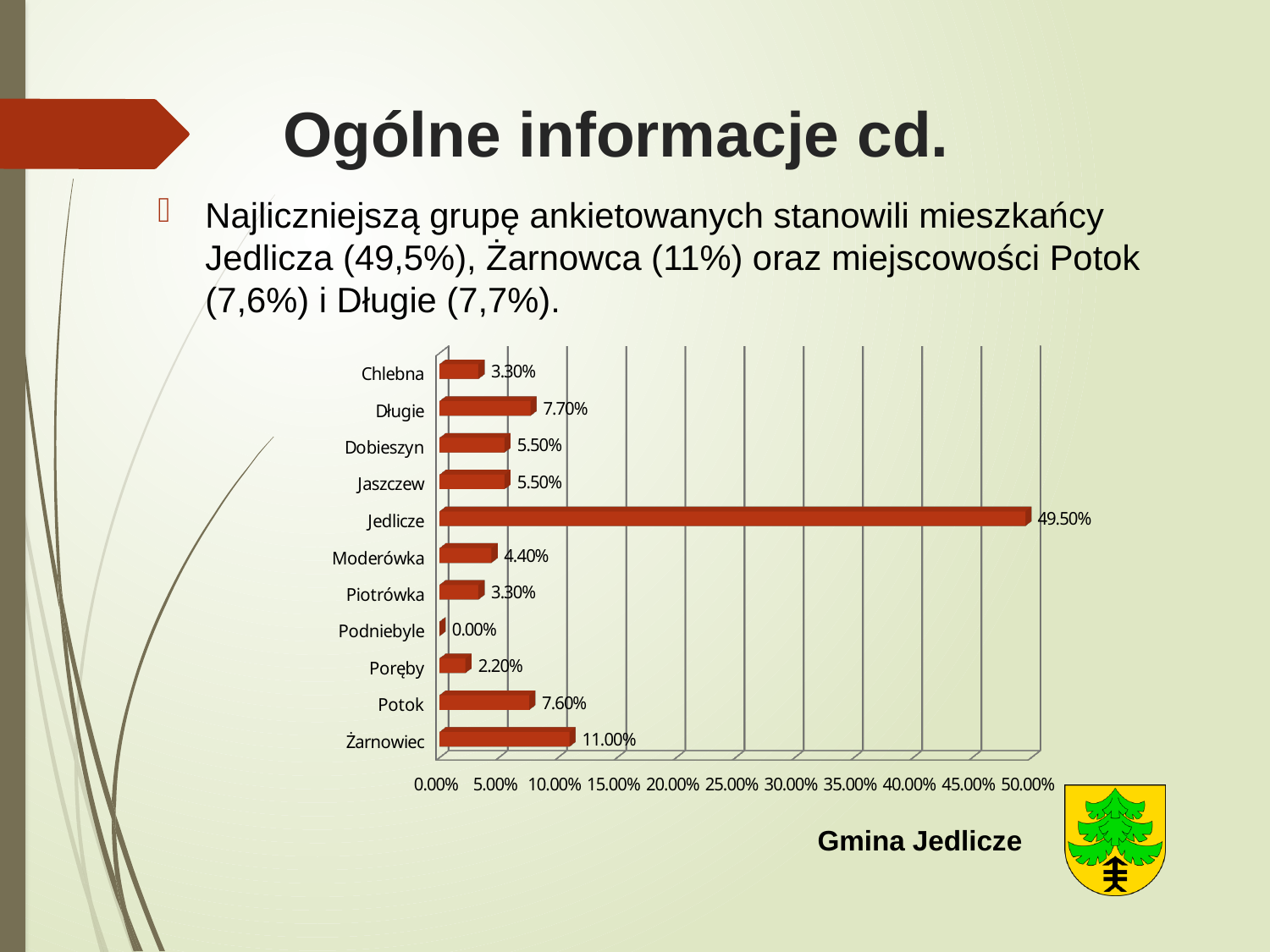
Which is larger, the value for Poręby or the value for Chlebna? Chlebna What is the difference between the values for Długie and Potok? 0.10% What is the value for Podniebyle? 0.00% What kind of chart is shown on the slide? bar chart What is the value for Żarnowiec? 11.00% What is the value for Moderówka? 4.40% What is the difference between the values for Jedlicze and Żarnowiec? 38.50% Which category has the lowest value? Podniebyle What is the value for Jedlicze? 49.50% How many categories are shown on the chart? 11 Which category has the highest value? Jedlicze Is the value for Jedlicze greater or less than 45.00%? greater